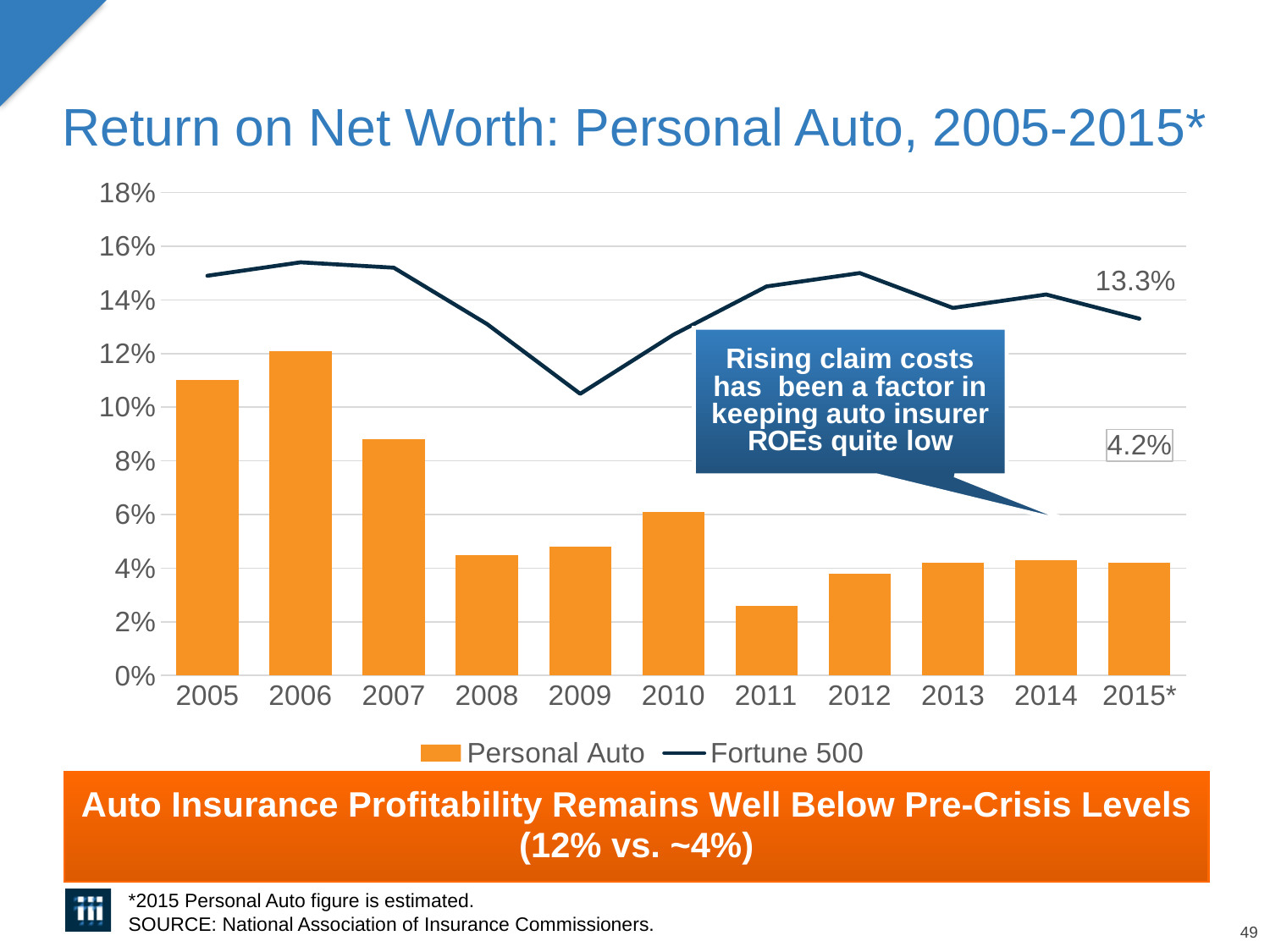
What is the Fortune 500 value shown for 2015*? 13.3% Is the Fortune 500 value for 2009 greater or less than 12%? less In which year is the Personal Auto bar the highest? 2006 What kind of chart is this? Combined bar and line chart What is the Personal Auto return on net worth for 2015*? 4.2% In which year does the Fortune 500 line reach its lowest point? 2009 Which year has the larger Personal Auto value, 2005 or 2006? 2006 How many series does the legend list? 2 In which year is the Personal Auto bar the lowest? 2011 How many years are shown on the x axis? 11 What is the difference between the Fortune 500 and Personal Auto values in 2015*? 9.1 percentage points Is the Personal Auto value for 2005 greater or less than 10%? greater